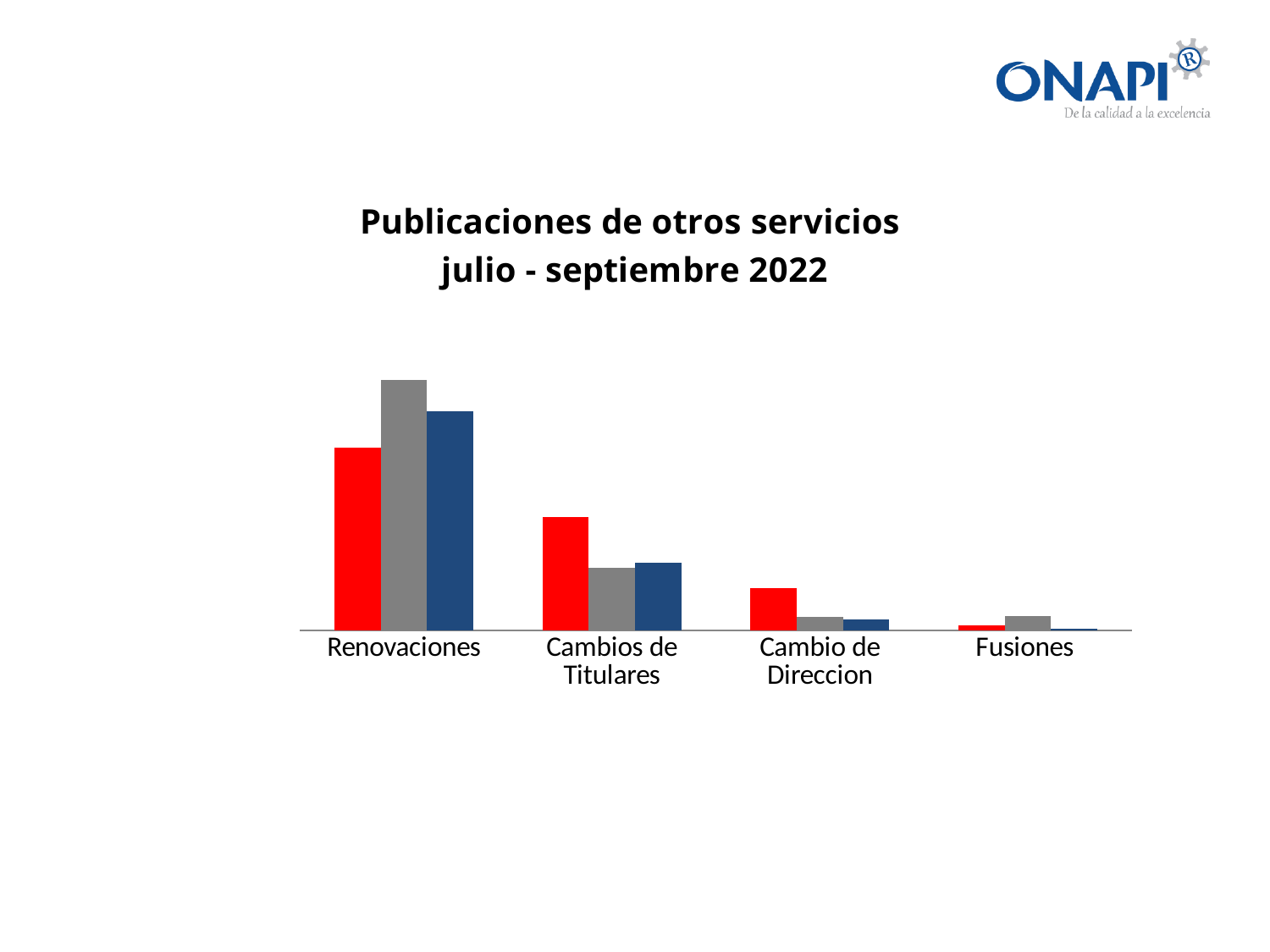
How many categories are shown on the x axis of the chart? 4 What kind of chart is shown on the slide? bar chart Within the Renovaciones category, which bar is tallest: the red, the gray or the blue one? gray What three colours are used for the bars in the chart? red, gray and blue Within the Cambio de Direccion category, is the red bar taller or shorter than the gray bar? taller Within the Cambios de Titulares category, which bar is tallest: the red, the gray or the blue one? red How many bars are shown for each category in the chart? 3 Which category has the lowest values in the chart? Fusiones Do the values of the red bars rise or fall from Renovaciones to Fusiones along the x axis? fall What is the title of the chart? Publicaciones de otros servicios julio - septiembre 2022 Which category has the highest values in the chart? Renovaciones